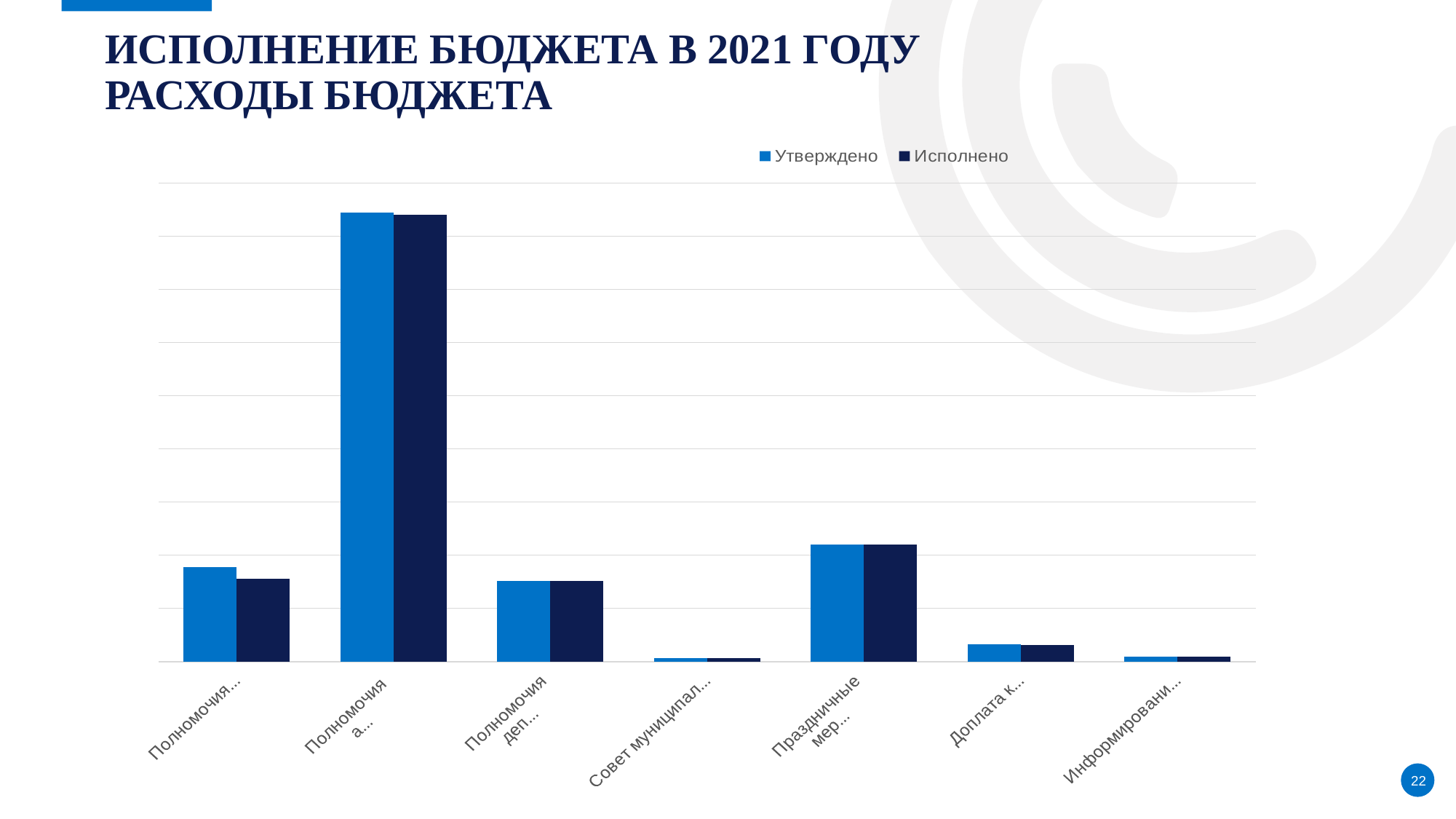
How many series does the chart legend list? 2 What are the two series named in the chart legend? Утверждено and Исполнено For the first category on the left (Полномочия...), which is larger: Утверждено or Исполнено? Утверждено How many categories are shown along the x axis of the chart? 7 Which colour represents the Исполнено series in the chart? Dark navy blue What kind of chart is shown on the slide? Bar chart Which category has the tallest bars in the chart? The second category from the left (Полномочия а...) Which has the larger Утверждено value: Праздничные мер... or Доплата к...? Праздничные мер... Which has the larger Утверждено value: Полномочия деп... or Совет муниципал...? Полномочия деп...